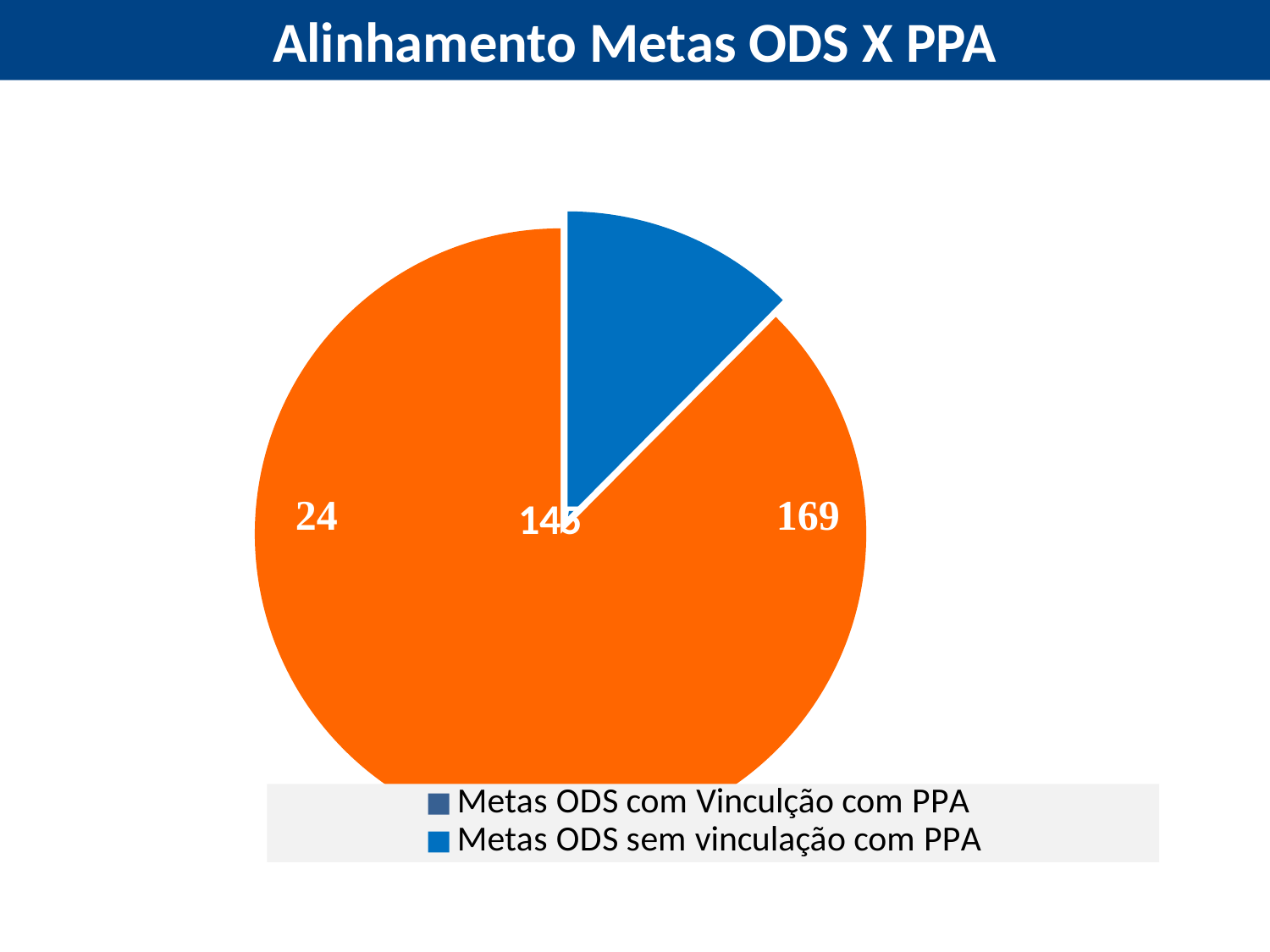
Is the blue slice greater or less than half of the pie? less What value is printed on the right side of the pie chart? 169 What is the first entry listed in the legend? Metas ODS com Vinculção com PPA What kind of chart is shown on the slide? pie chart How many entries does the legend list? 2 Which slice is the smallest in the pie chart? the blue slice Which slice is larger, the orange slice or the blue slice? the orange slice What is the title of the slide's chart? Alinhamento Metas ODS X PPA How many slices does the pie chart have? 2 What value is printed on the left side of the pie chart? 24